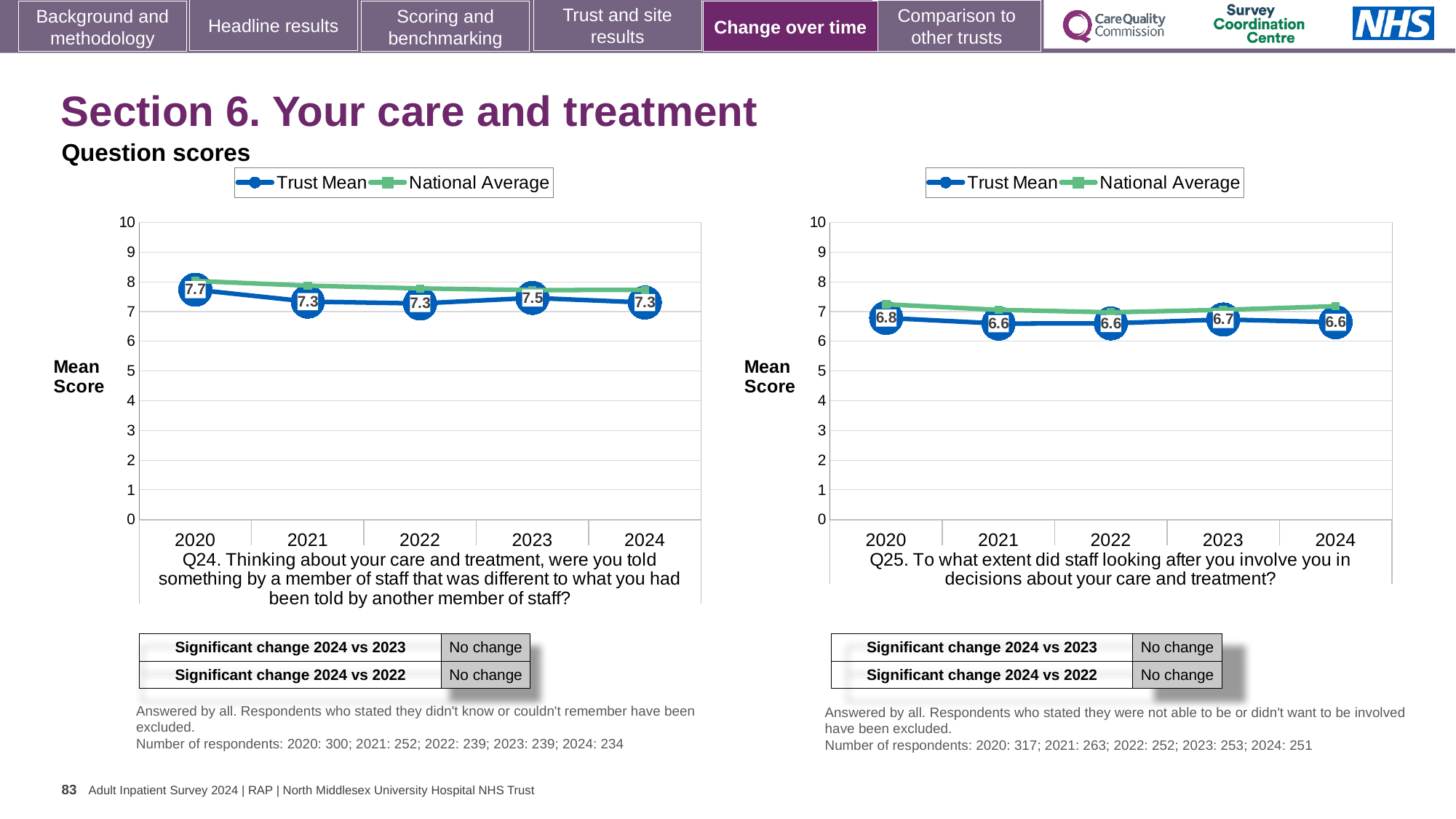
On the Q24 chart (left), what is the Trust Mean score for 2023? 7.5 On the Q25 chart (right), which year has the highest Trust Mean score? 2020 What type of chart is the Q25 chart (right)? Line chart On the Q24 chart (left), which year has the highest Trust Mean score? 2020 On the Q25 chart (right), what is the difference between the Trust Mean scores for 2023 and 2022? 0.1 On the Q25 chart (right), what is the Trust Mean score for 2020? 6.8 On the Q24 chart (left), is the Trust Mean score for 2021 greater or less than 8? less How many years are plotted on the Q25 chart (right)? 5 On the Q24 chart (left), what is the Trust Mean score for 2020? 7.7 How many series does the legend of the Q24 chart (left) list? 2 On the Q25 chart (right), what is the Trust Mean score for 2024? 6.6 On the Q24 chart (left), what is the difference between the Trust Mean scores for 2020 and 2024? 0.4